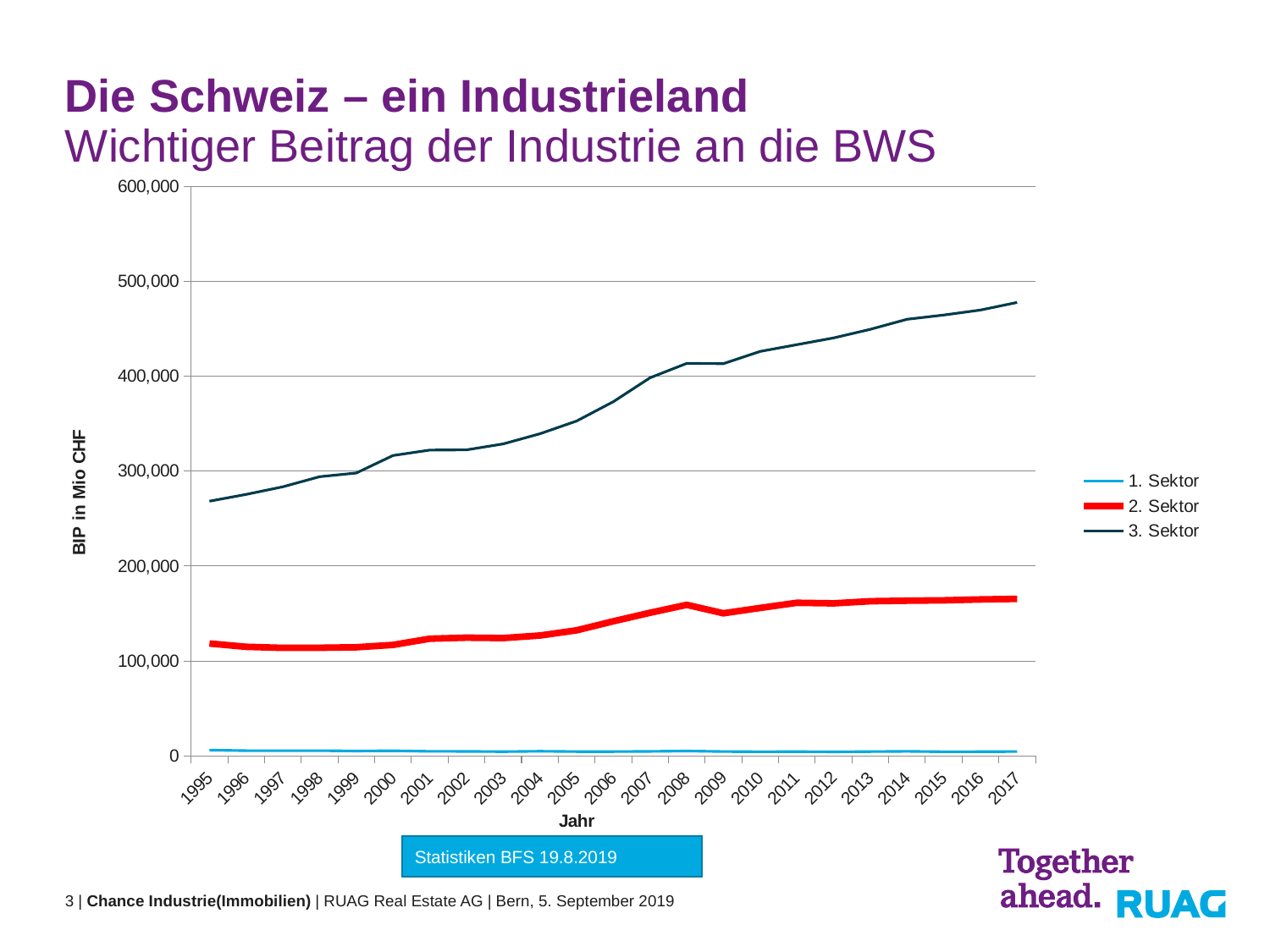
Is the value for 2. Sektor in 2017 greater or less than 200,000? less Is the value for 3. Sektor in 1995 greater or less than 300,000? less Which is larger in 2017, the value for 2. Sektor or the value for 3. Sektor? 3. Sektor Is the value for 2. Sektor in 1995 greater or less than 100,000? greater Which series has the highest values throughout the chart? 3. Sektor Does the value for 3. Sektor rise or fall from 1995 to 2017? rise What is the label of the y axis? BIP in Mio CHF How many years are shown on the x axis of the chart? 23 What kind of chart is shown on the slide? line chart Which series has the lowest values throughout the chart? 1. Sektor How many series does the legend list? 3